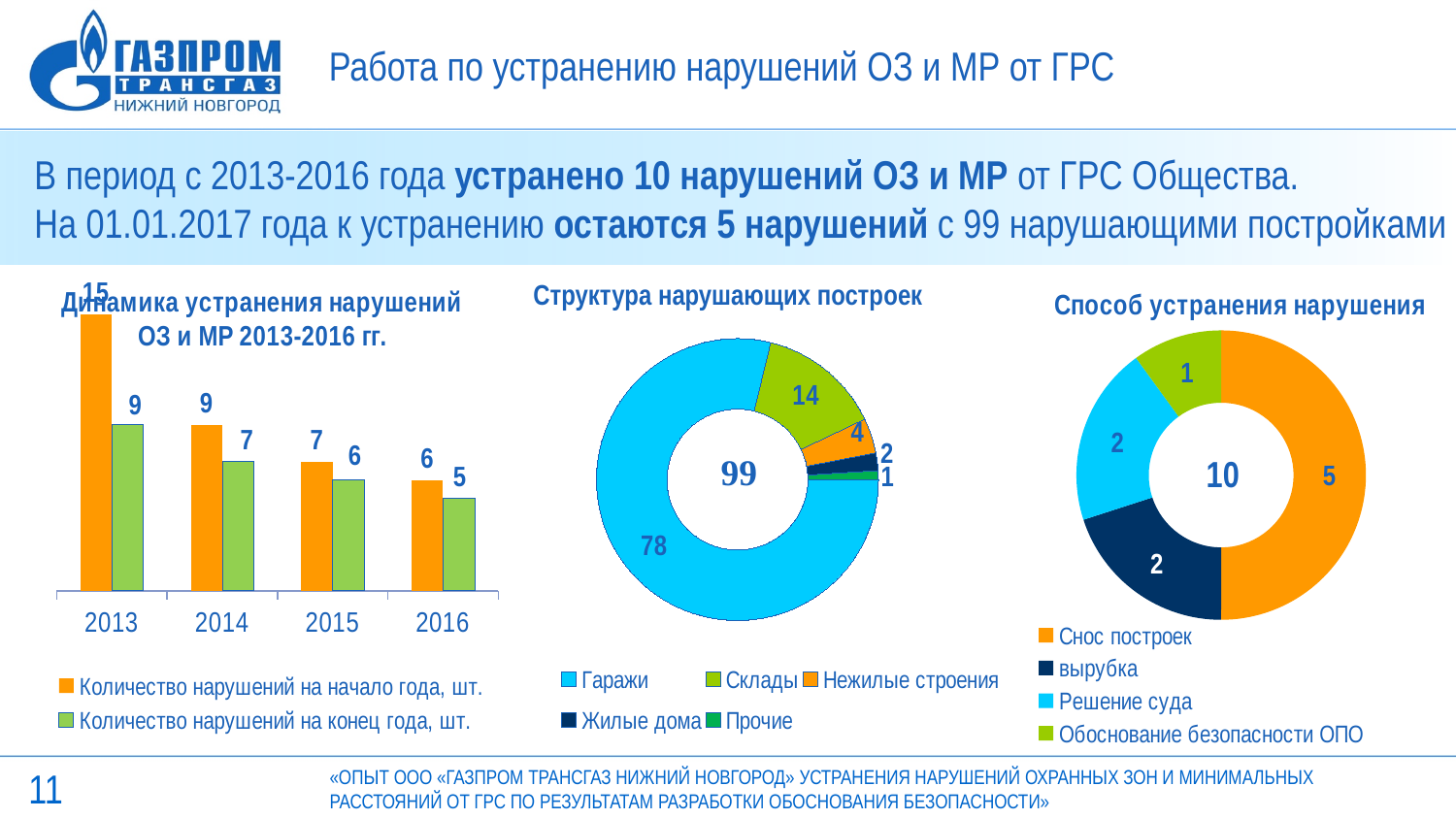
In the chart "Динамика устранения нарушений ОЗ и МР 2013-2016 гг.", what is the value of "Количество нарушений на конец года, шт." for 2016? 5 In the chart "Структура нарушающих построек", what is the difference between "Склады" and "Нежилые строения"? 10 How many series does the legend of the chart "Динамика устранения нарушений ОЗ и МР 2013-2016 гг." list? 2 In the chart "Способ устранения нарушения", which category has the highest value? Снос построек In the chart "Динамика устранения нарушений ОЗ и МР 2013-2016 гг.", does the "Количество нарушений на начало года, шт." series rise or fall from 2013 to 2016? fall In the chart "Структура нарушающих построек", which category has the lowest value? Прочие In the chart "Способ устранения нарушения", what is the value for "Обоснование безопасности ОПО"? 1 In the chart "Структура нарушающих построек", what is the value for "Гаражи"? 78 In the chart "Динамика устранения нарушений ОЗ и МР 2013-2016 гг.", what is the value of "Количество нарушений на начало года, шт." for 2013? 15 What kind of chart is "Динамика устранения нарушений ОЗ и МР 2013-2016 гг."? bar chart In the chart "Динамика устранения нарушений ОЗ и МР 2013-2016 гг.", what is the difference between the start-of-year and end-of-year values for 2013? 6 How many categories does the chart "Структура нарушающих построек" show? 5